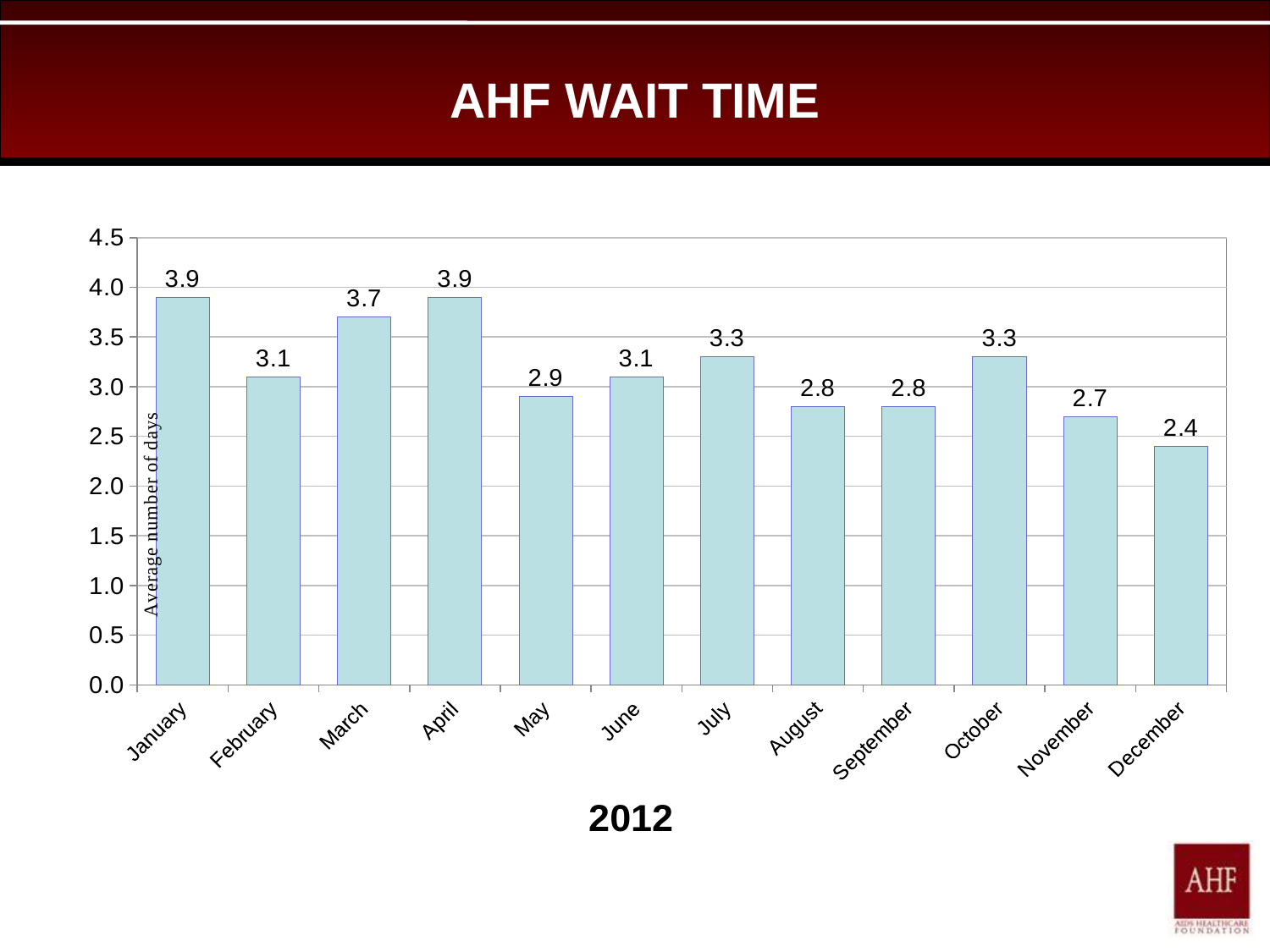
What is the difference in average wait time between April and May? 1.0 What is the average wait time in days for March? 3.7 Which month has the lowest average wait time? December How many months are shown on the x axis? 12 What is the difference in average wait time between January and December? 1.5 What is the label on the y axis? Average number of days Do the values generally rise or fall from January to December? fall Which has a higher average wait time, July or August? July What is the average wait time in days for December? 2.4 What is the average wait time in days for October? 3.3 What kind of chart is shown on the slide? bar chart Is the value for November greater or less than 3.0? less